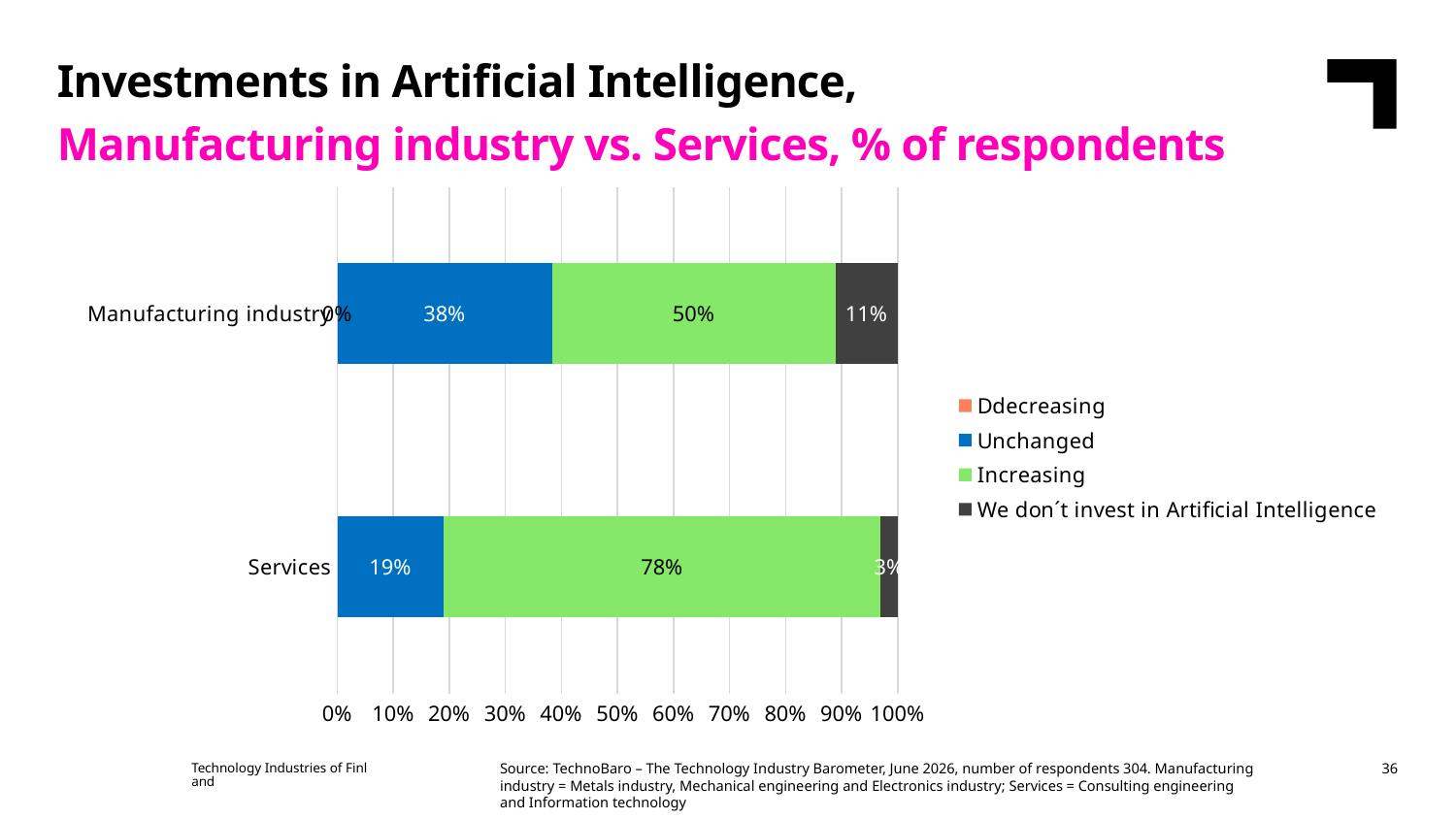
Which legend entry is shown in green? Increasing How many categories are shown on the chart? 2 What is the difference between the Increasing values for Services and Manufacturing industry? 28 percentage points What is the Increasing value for Manufacturing industry? 50% Which category has the higher Increasing value, Manufacturing industry or Services? Services What is the Unchanged value for Services? 19% What kind of chart is shown on the slide? Stacked bar chart What is the Increasing value for Services? 78% What is the difference between the Unchanged values for Manufacturing industry and Services? 19 percentage points What share of Manufacturing industry respondents answered 'We don't invest in Artificial Intelligence'? 11% How many series does the legend list? 4 What is the Unchanged value for Manufacturing industry? 38%